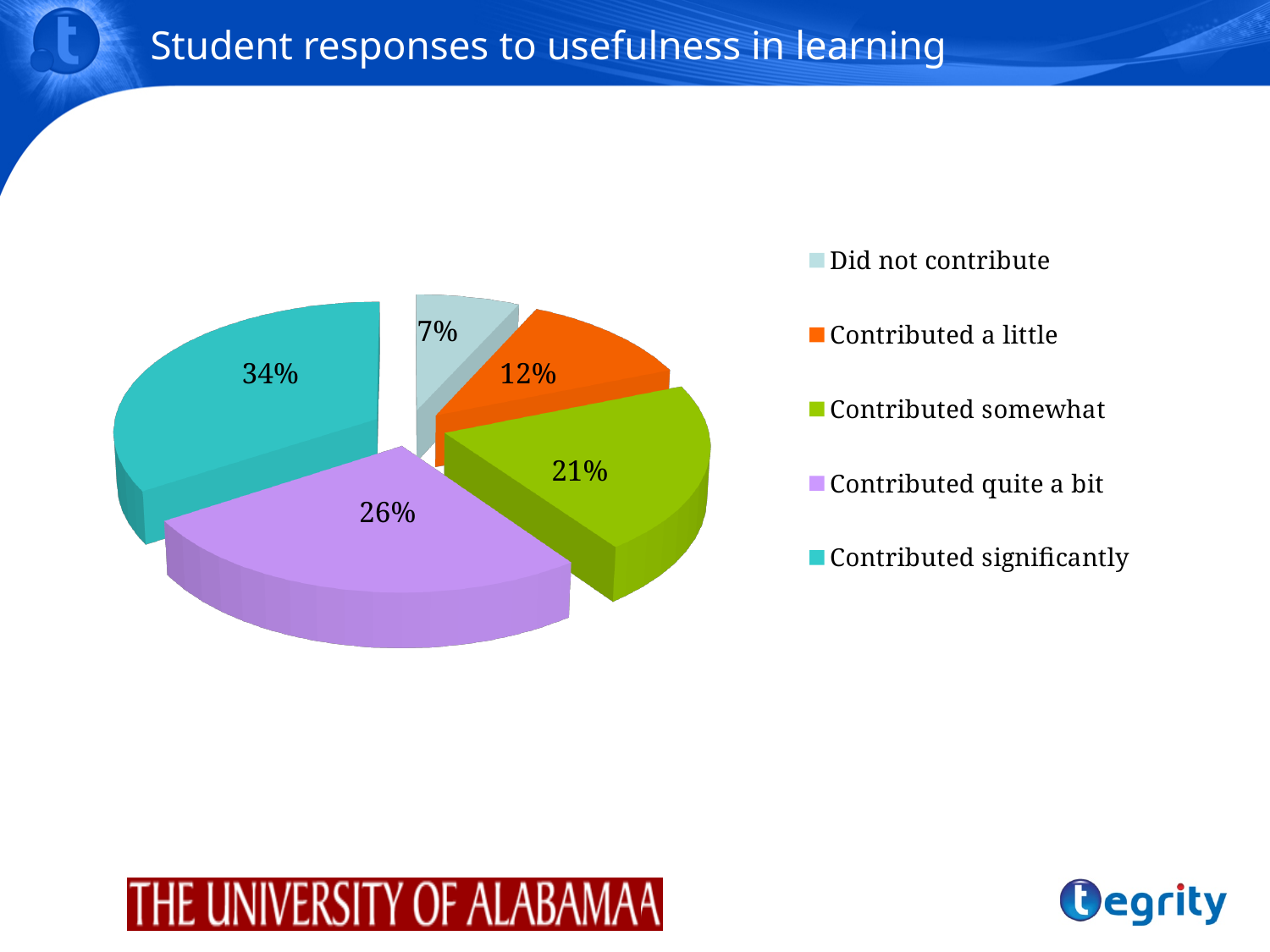
What percentage of students responded "Contributed quite a bit"? 26% What is the title of the slide containing the pie chart? Student responses to usefulness in learning What percentage of students responded "Did not contribute"? 7% Which response category has the smallest share of the pie? Did not contribute What percentage of students responded "Contributed significantly"? 34% What kind of chart is shown on the slide? pie chart Which response category has the largest share of the pie? Contributed significantly What percentage of students responded "Contributed somewhat"? 21% What percentage of students responded "Contributed a little"? 12% Which is larger, the share for "Contributed somewhat" or the share for "Contributed a little"? Contributed somewhat What is the difference in percentage points between "Contributed significantly" and "Contributed quite a bit"? 8 How many response categories does the pie chart show? 5